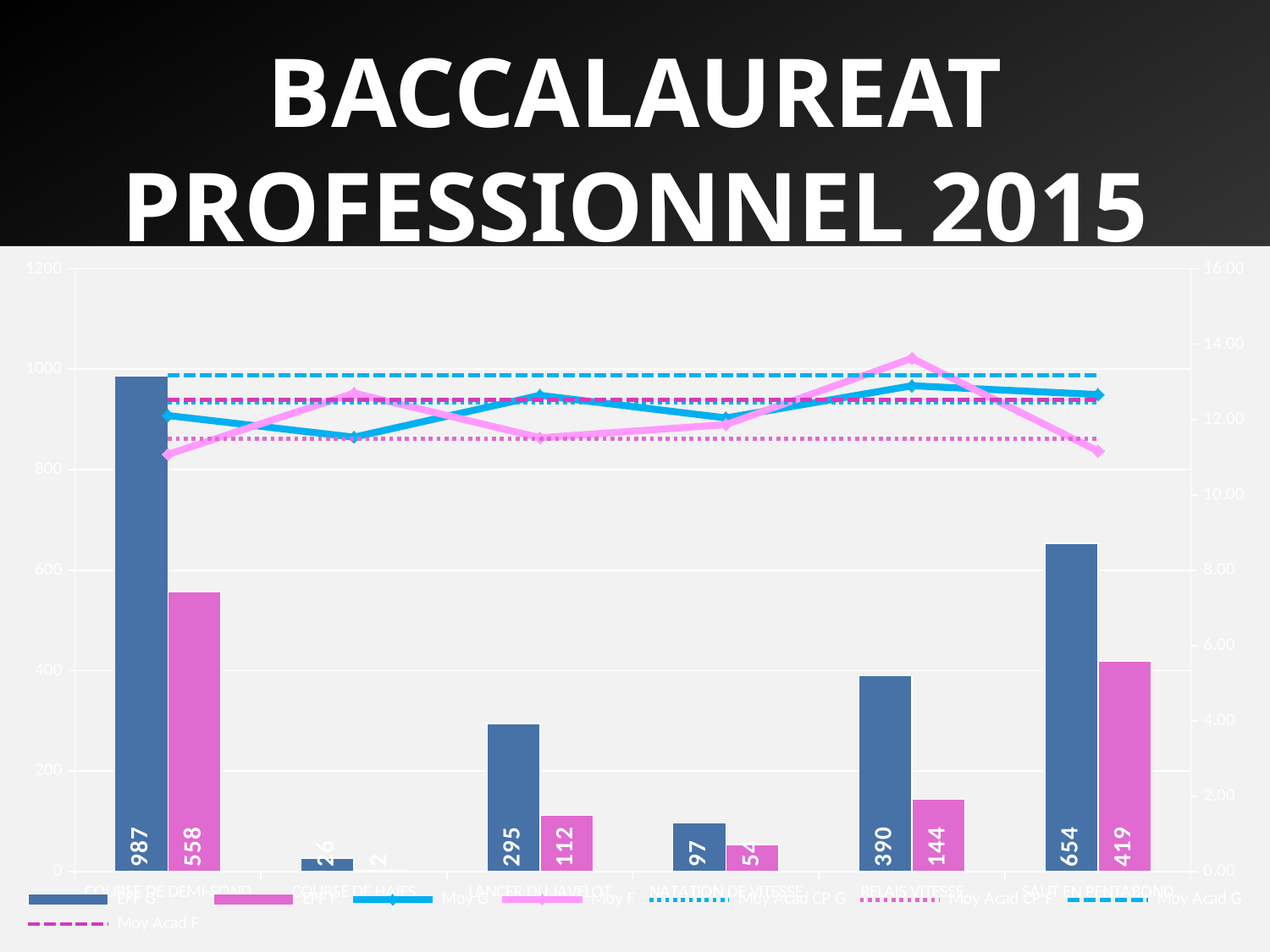
What is the EFF F value for SAUT EN PENTABOND? 419 Which category has the lowest EFF G value? COURSE DE HAIES What is the difference between EFF G and EFF F for COURSE DE DEMI-FOND? 429 What is the EFF G value for COURSE DE DEMI-FOND? 987 Which category has the highest EFF G value? COURSE DE DEMI-FOND What is the EFF G value for RELAIS VITESSE? 390 How many categories are shown on the x axis? 6 What is the difference between EFF G and EFF F for RELAIS VITESSE? 246 Which is larger, the EFF G value for LANCER DU JAVELOT or for RELAIS VITESSE? RELAIS VITESSE Is the Moy F value for SAUT EN PENTABOND greater or less than 12.00? less How many series does the legend list? 8 What is the title of the slide? BACCALAUREAT PROFESSIONNEL 2015